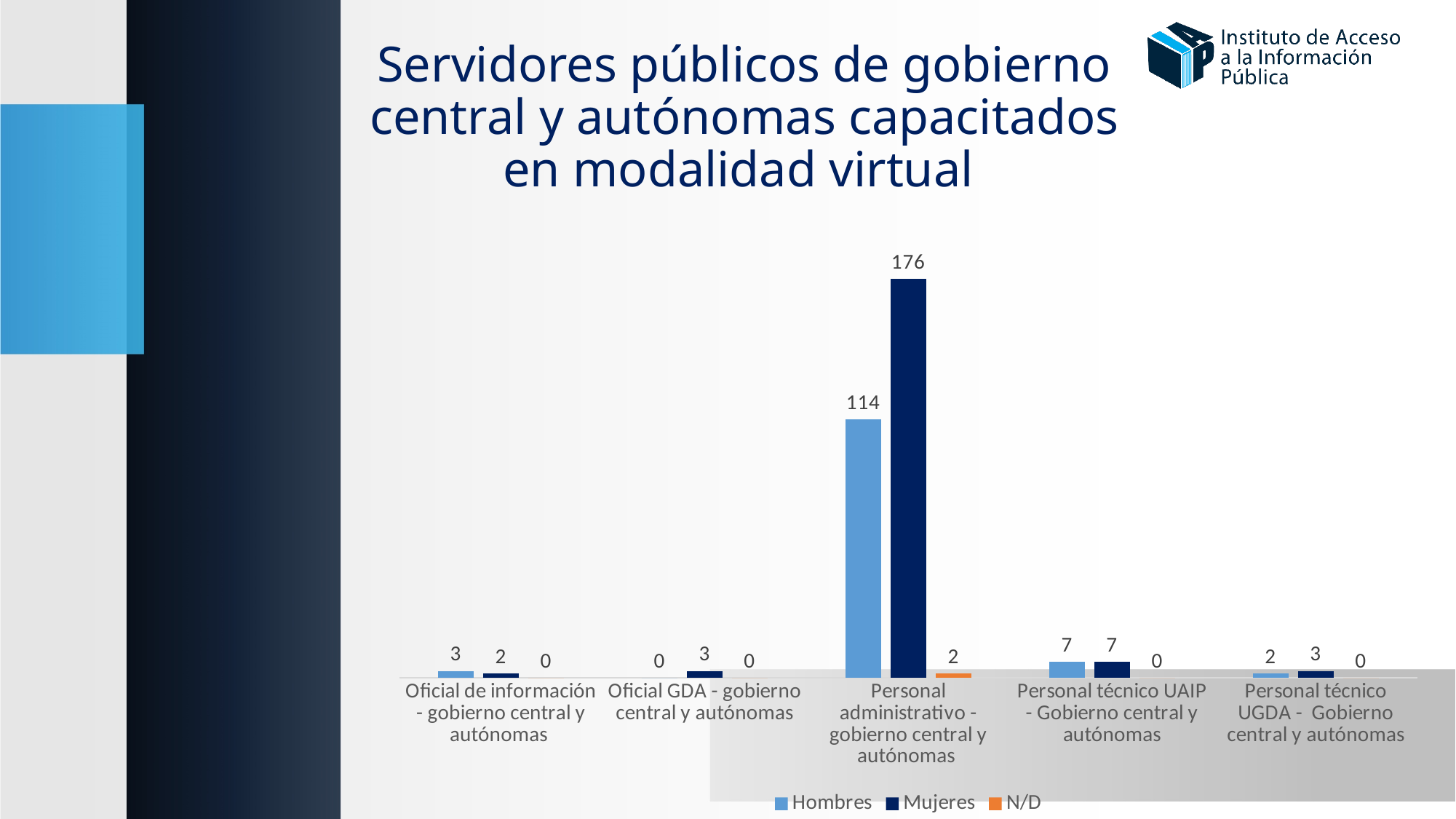
How many series does the legend list? 3 What kind of chart is shown on the slide? Bar chart What is the Hombres value for Personal administrativo - gobierno central y autónomas? 114 Which category has the lowest Hombres value? Oficial GDA - gobierno central y autónomas What is the difference between the Mujeres and Hombres values for Personal administrativo - gobierno central y autónomas? 62 What is the Mujeres value for Personal técnico UGDA - Gobierno central y autónomas? 3 Which is larger for Personal técnico UGDA - Gobierno central y autónomas: Hombres or Mujeres? Mujeres What is the Mujeres value for Personal administrativo - gobierno central y autónomas? 176 Which category has the highest Mujeres value? Personal administrativo - gobierno central y autónomas What is the Hombres value for Oficial de información - gobierno central y autónomas? 3 What is the N/D value for Personal administrativo - gobierno central y autónomas? 2 How many categories are shown on the x axis? 5